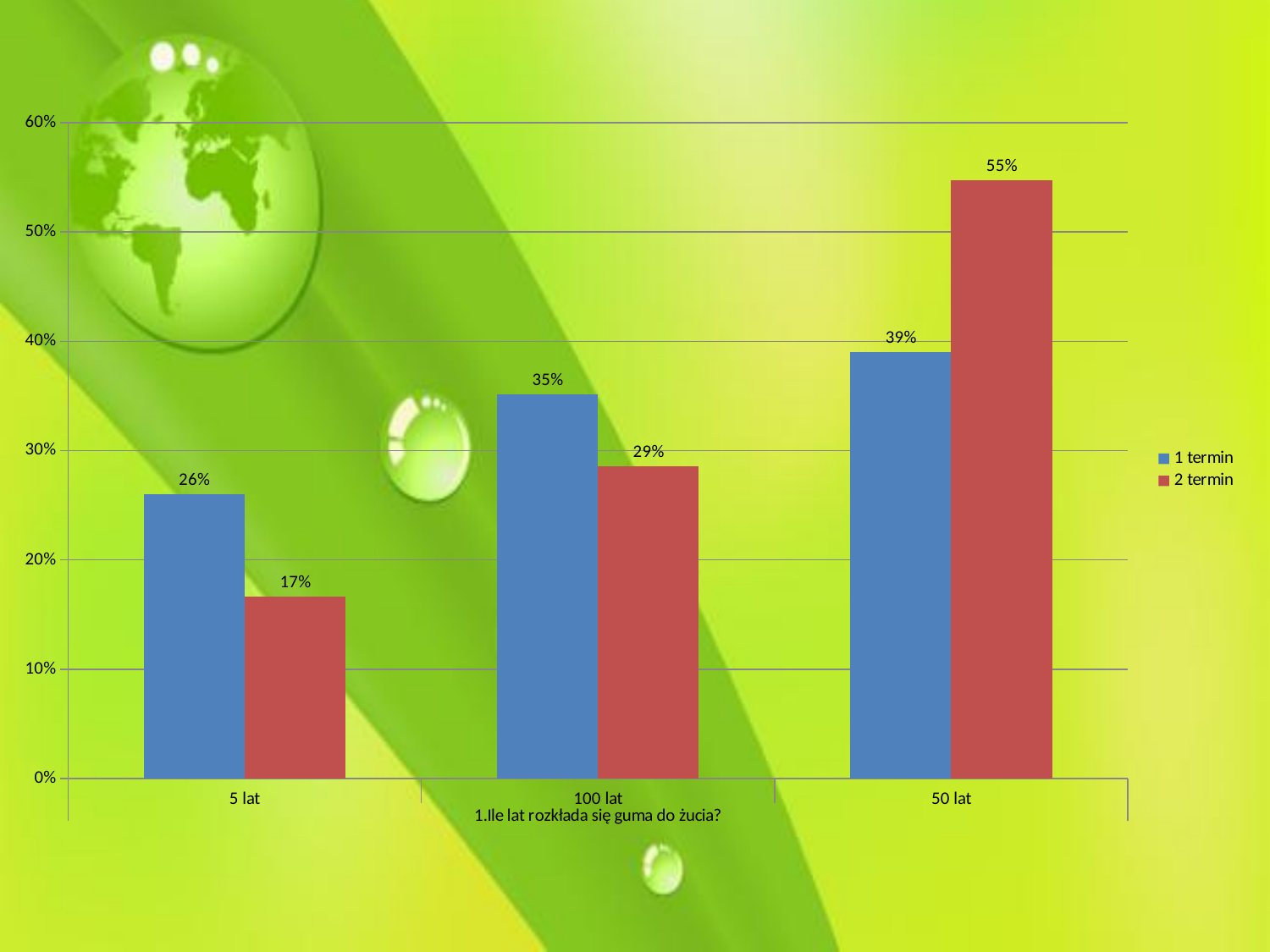
Which category has the highest value for "2 termin"? 50 lat How many series does the legend list? 2 What is the difference between the "2 termin" and "1 termin" values in the "50 lat" category? 16% What is the x-axis title of the chart? 1.Ile lat rozkłada się guma do żucia? How many categories are shown on the x axis? 3 What is the value for "2 termin" in the "50 lat" category? 55% What is the value for "1 termin" in the "5 lat" category? 26% In the "100 lat" category, which series has the larger value, "1 termin" or "2 termin"? 1 termin What is the value for "2 termin" in the "100 lat" category? 29% Which category has the lowest value for "1 termin"? 5 lat What kind of chart is shown on the slide? bar chart Is the value for "2 termin" in the "5 lat" category greater or less than 20%? less